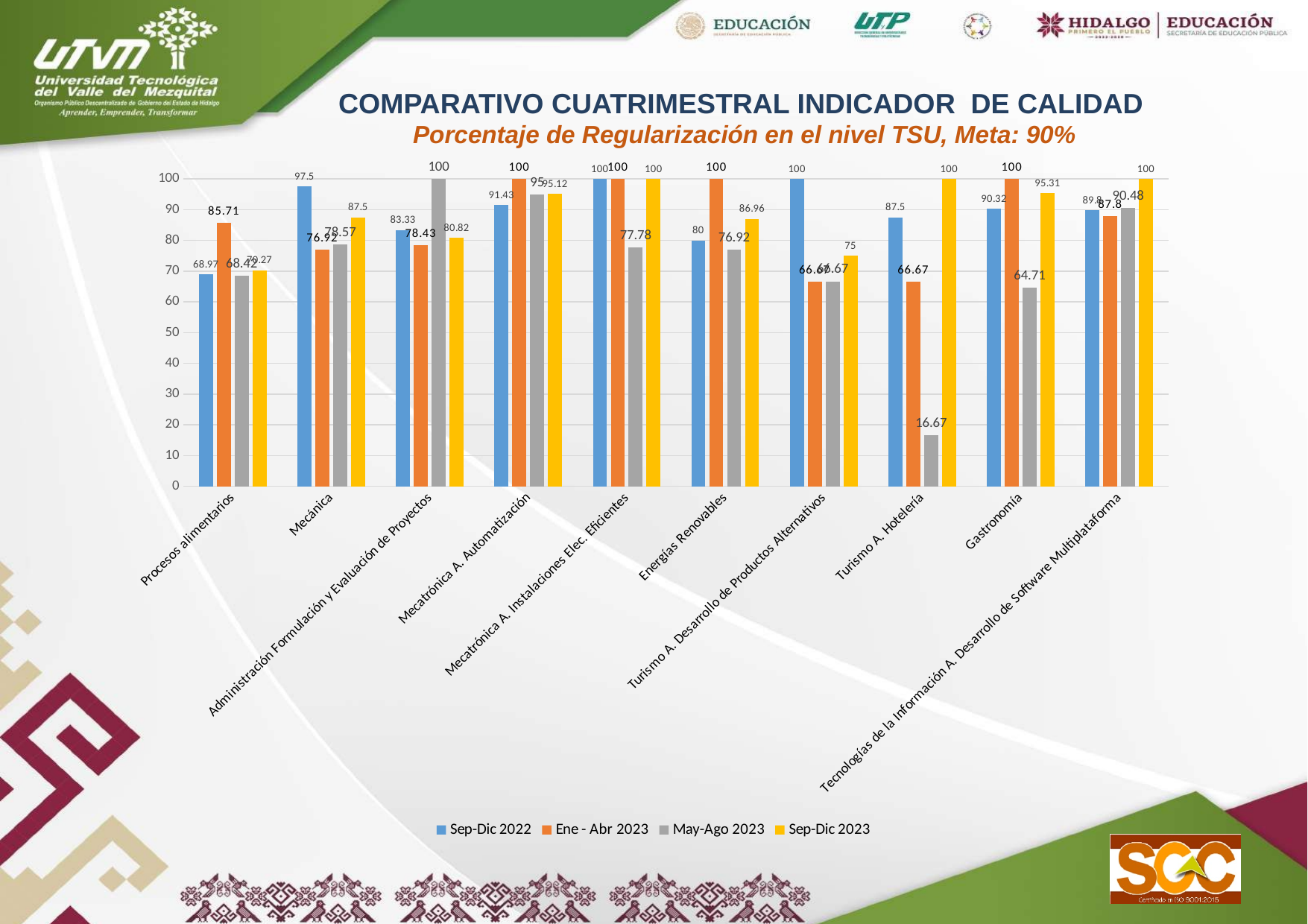
What target (Meta) is stated in the chart subtitle? 90% Which is larger for Procesos alimentarios: the Ene - Abr 2023 value or the Sep-Dic 2023 value? Ene - Abr 2023 Which category has the highest value in the Sep-Dic 2022 series? Mecatrónica A. Instalaciones Elec. Eficientes and Turismo A. Desarrollo de Productos Alternativos (both 100) How many categories are shown on the x axis? 10 Which category has the lowest value in the May-Ago 2023 series? Turismo A. Hotelería What is the difference between the Sep-Dic 2022 and Ene - Abr 2023 values for Mecánica? 20.58 What is the value for Energías Renovables in the Sep-Dic 2023 series? 86.96 What is the value for Turismo A. Hotelería in the May-Ago 2023 series? 16.67 What kind of chart is shown on the slide? Bar chart What is the value for Gastronomía in the May-Ago 2023 series? 64.71 How many series does the legend list? 4 What is the value for Mecánica in the Sep-Dic 2022 series? 97.5